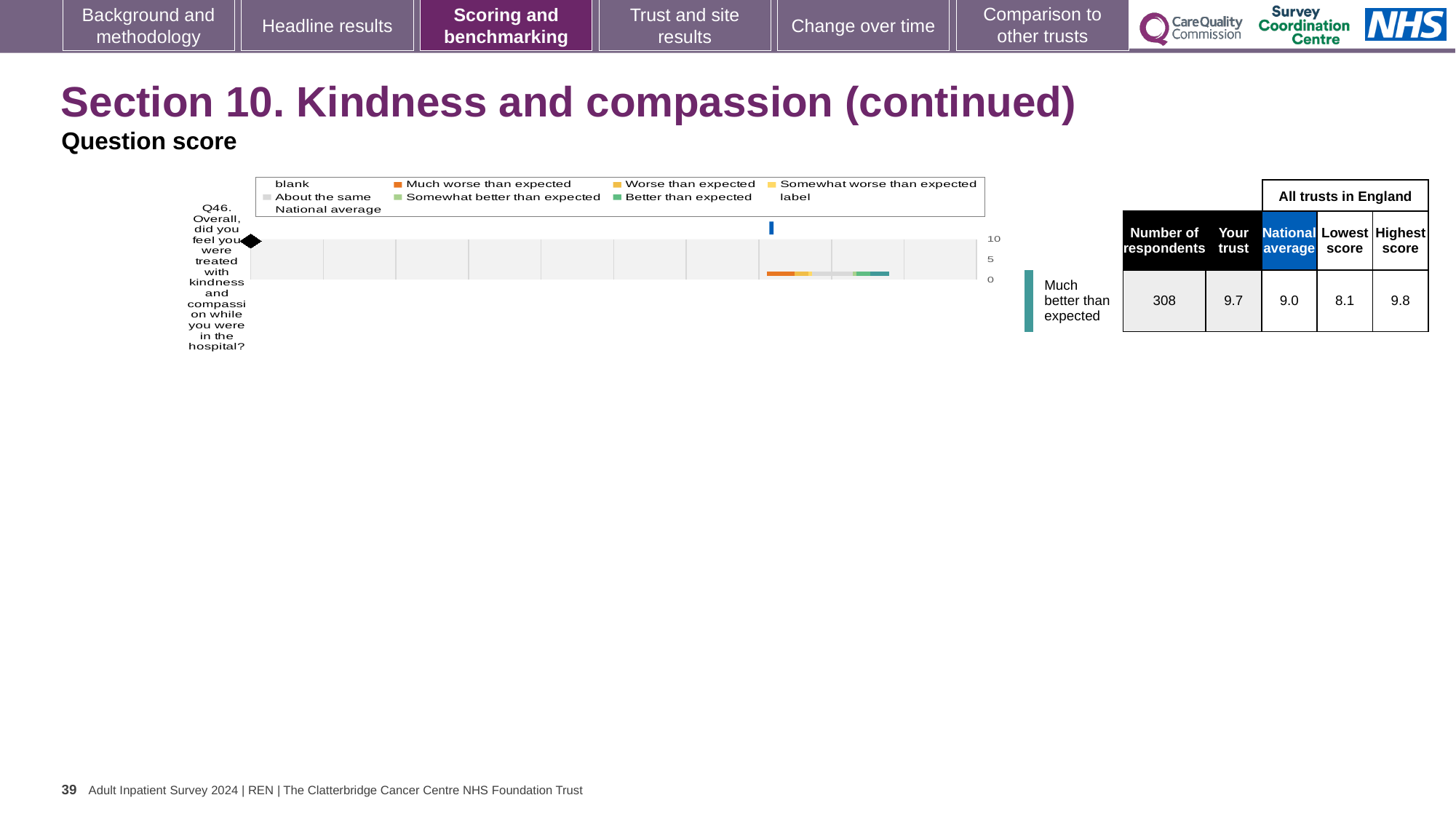
In the table next to the chart, what is the lowest score among all trusts in England for Q46? 8.1 In the table next to the chart, what is the number of respondents for Q46? 308 What kind of chart is shown on the slide? bar chart What rating label is shown to the right of the chart for Q46? Much better than expected In the table next to the chart, what is the highest score among all trusts in England for Q46? 9.8 In the table next to the chart, what is the national average for Q46? 9.0 What is the difference between the 'Your trust' score and the national average for Q46? 0.7 How many questions (categories) are plotted in the chart? 1 In the table next to the chart, what is the 'Your trust' score for Q46? 9.7 What is the highest value shown on the chart's axis? 10 Is the 'Your trust' score for Q46 larger or smaller than the national average? larger Which question is plotted in the chart? Q46. Overall, did you feel you were treated with kindness and compassion while you were in the hospital?